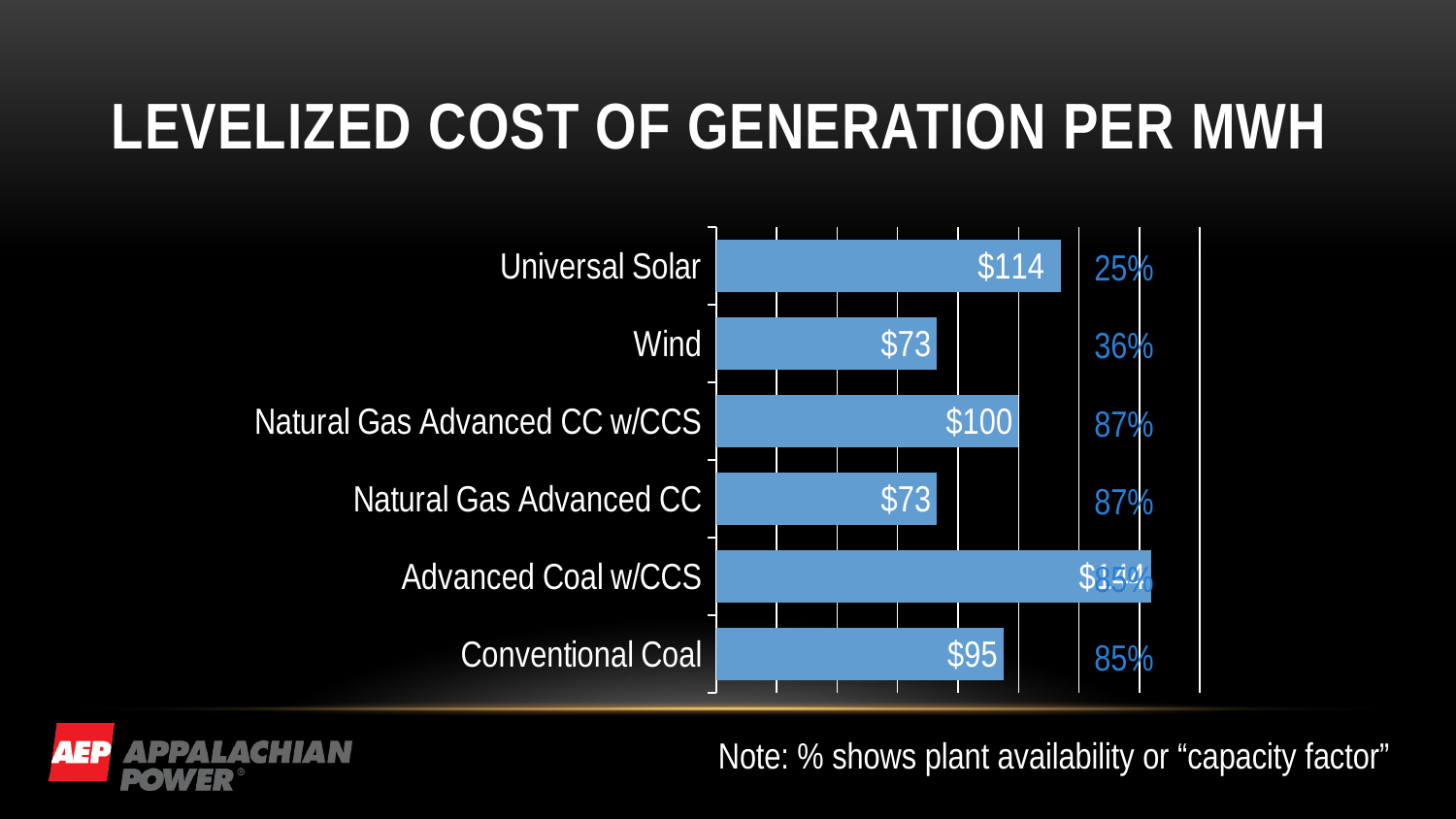
What is the levelized cost per MWh for Universal Solar? $114 Which generation type has the highest levelized cost per MWh? Advanced Coal w/CCS What capacity factor percentage is shown next to Universal Solar? 25% How many generation types are shown in the chart? 6 What capacity factor percentage is shown next to Wind? 36% What is the levelized cost per MWh for Natural Gas Advanced CC w/CCS? $100 What is the levelized cost per MWh for Conventional Coal? $95 Which has a higher levelized cost, Universal Solar or Conventional Coal? Universal Solar What is the difference in levelized cost between Natural Gas Advanced CC w/CCS and Natural Gas Advanced CC? $27 What kind of chart is shown on the slide? Bar chart What is the difference in levelized cost between Universal Solar and Conventional Coal? $19 What is the levelized cost per MWh for Wind? $73